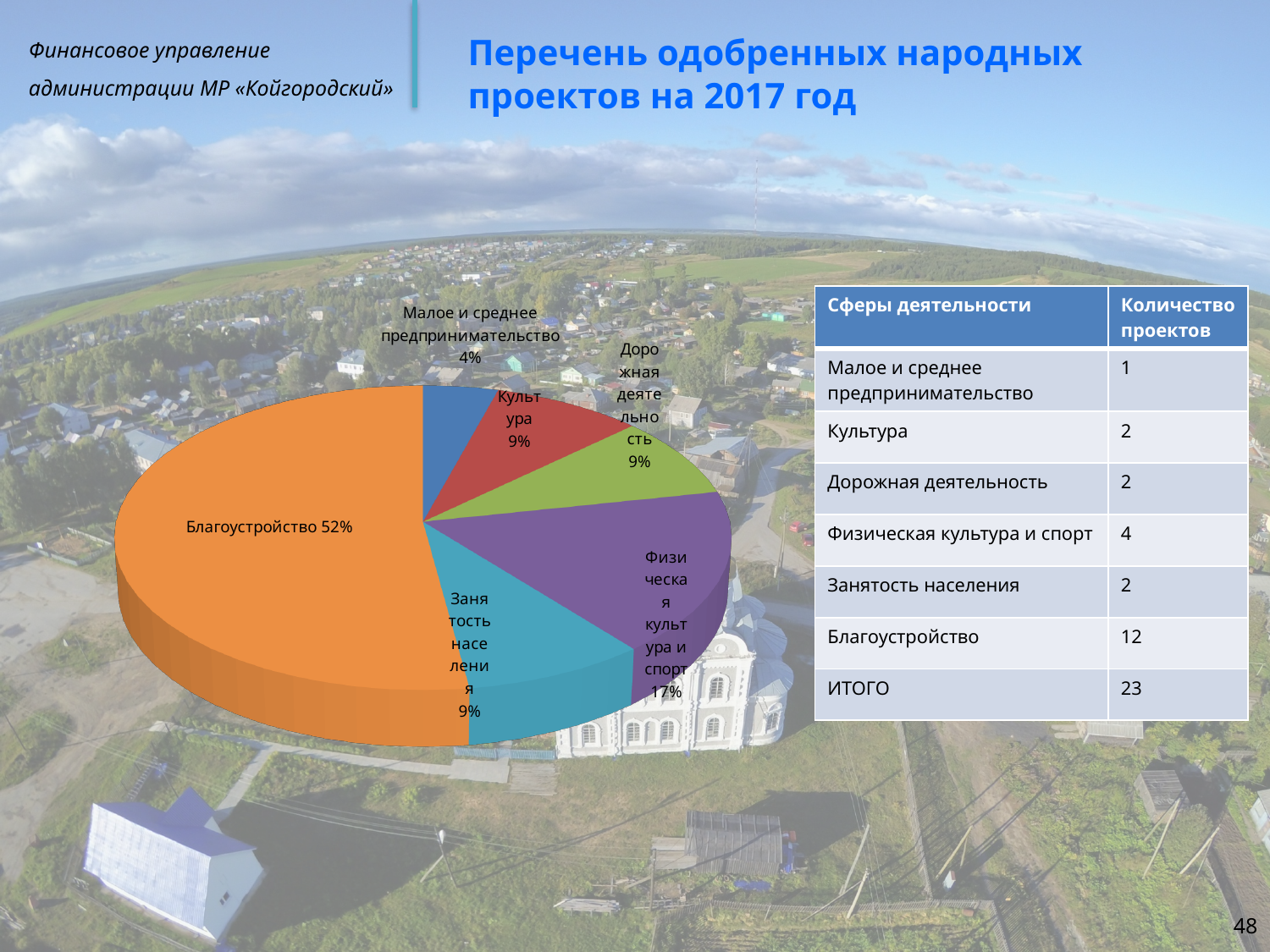
What colour is the Благоустройство slice in the pie chart? orange Which slice of the pie chart is the smallest? Малое и среднее предпринимательство Which is larger in the pie chart: Физическая культура и спорт or Занятость населения? Физическая культура и спорт Which slice of the pie chart is the largest? Благоустройство What share of the pie does Культура have? 9% What share of the pie does Физическая культура и спорт have? 17% What kind of chart is shown on the slide? pie chart What share of the pie does Благоустройство have? 52% Is the share for Благоустройство greater or less than 50%? greater What is the difference in percentage points between the Благоустройство slice and the Физическая культура и спорт slice? 35 How many slices does the pie chart have? 6